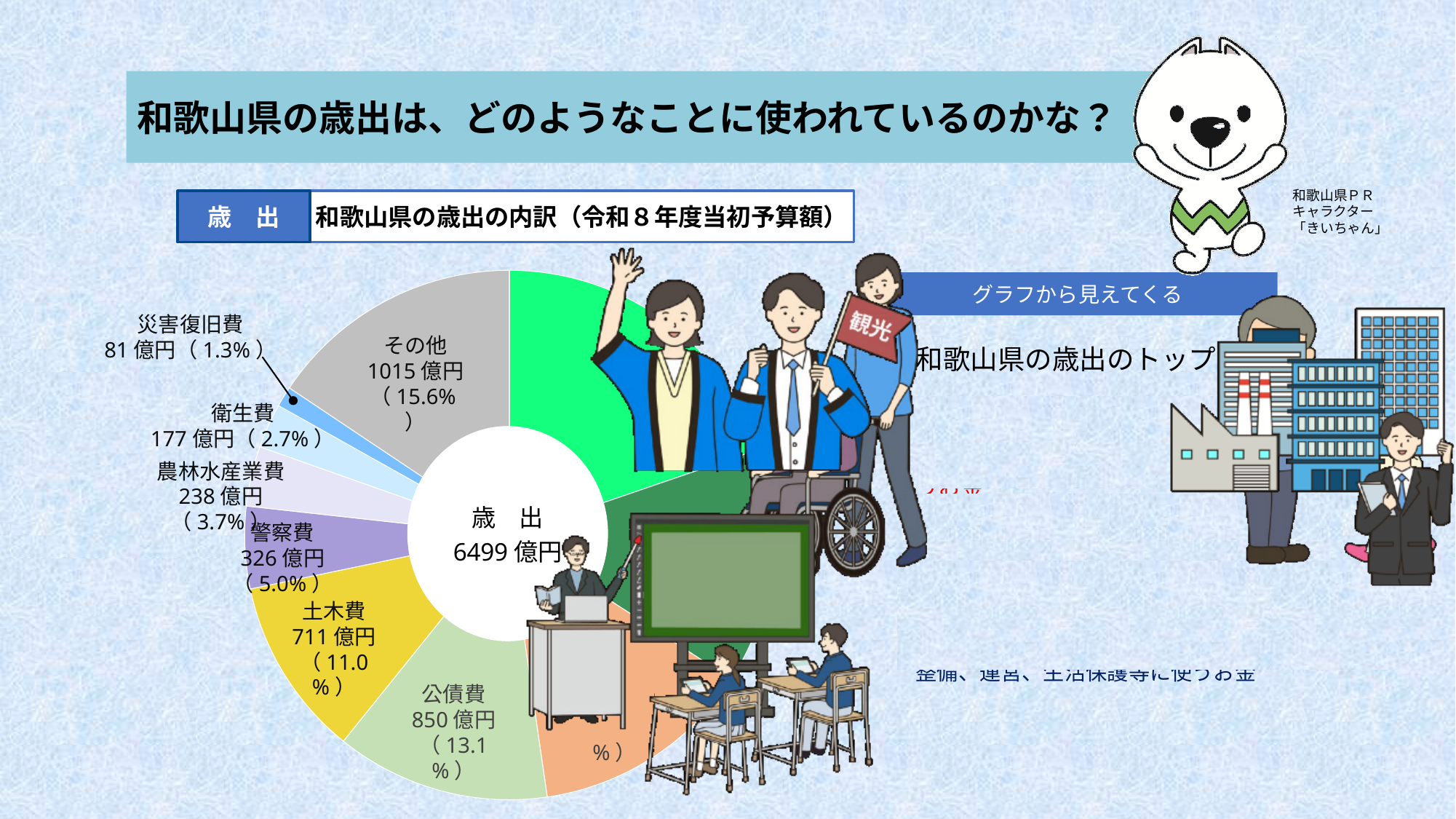
What is the difference between 公債費 and 土木費? 139億円 What type of chart is shown on the slide? pie chart What is the value for 災害復旧費? 81億円 What is the title of the chart shown on the slide? 和歌山県の歳出の内訳（令和８年度当初予算額） What is the difference between 警察費 and 衛生費? 149億円 What share of the total does その他 represent? 15.6% What is the value for 土木費? 711億円 Which is larger, 衛生費 or 農林水産業費? 農林水産業費 What is the total expenditure shown in the centre of the chart? 6499億円 What share of the total does 農林水産業費 represent? 3.7% What is the value for 公債費? 850億円 What is the value for 警察費? 326億円